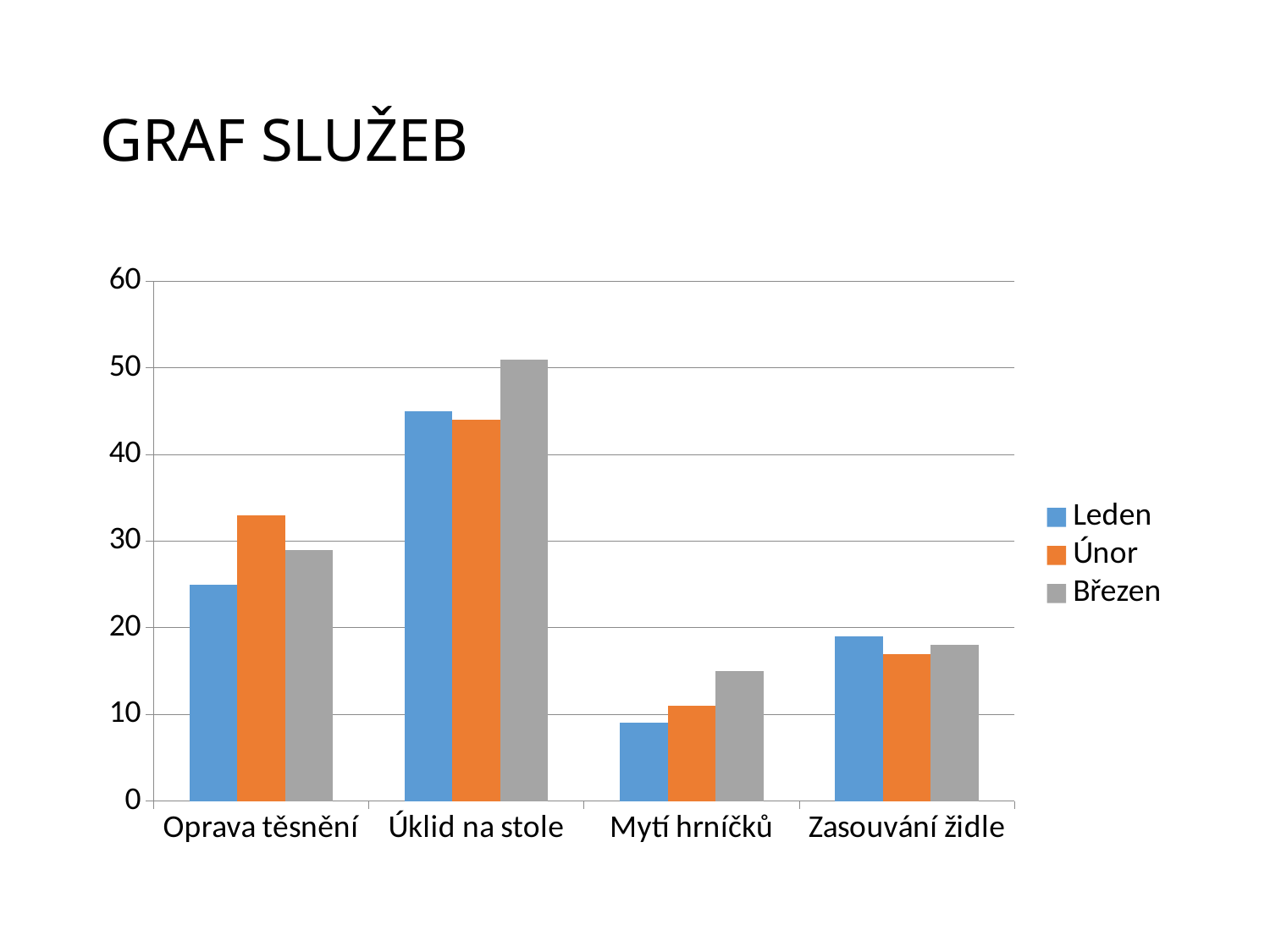
Which category has the lowest bar in the chart? Mytí hrníčků What is the title of the slide containing the chart? GRAF SLUŽEB Is the Únor value for Oprava těsnění greater or less than 30? greater Is the Březen value for Mytí hrníčků greater or less than 20? less How many categories are shown on the x axis of the chart? 4 For Mytí hrníčků, which is larger: the Leden value or the Březen value? Březen What kind of chart is shown on the slide? bar chart For Oprava těsnění, which is larger: the Leden value or the Únor value? Únor Which category has the highest bar in the chart? Úklid na stole Which series is shown in orange in the chart? Únor How many series does the chart's legend list? 3 Is the Leden value for Úklid na stole greater or less than 40? greater